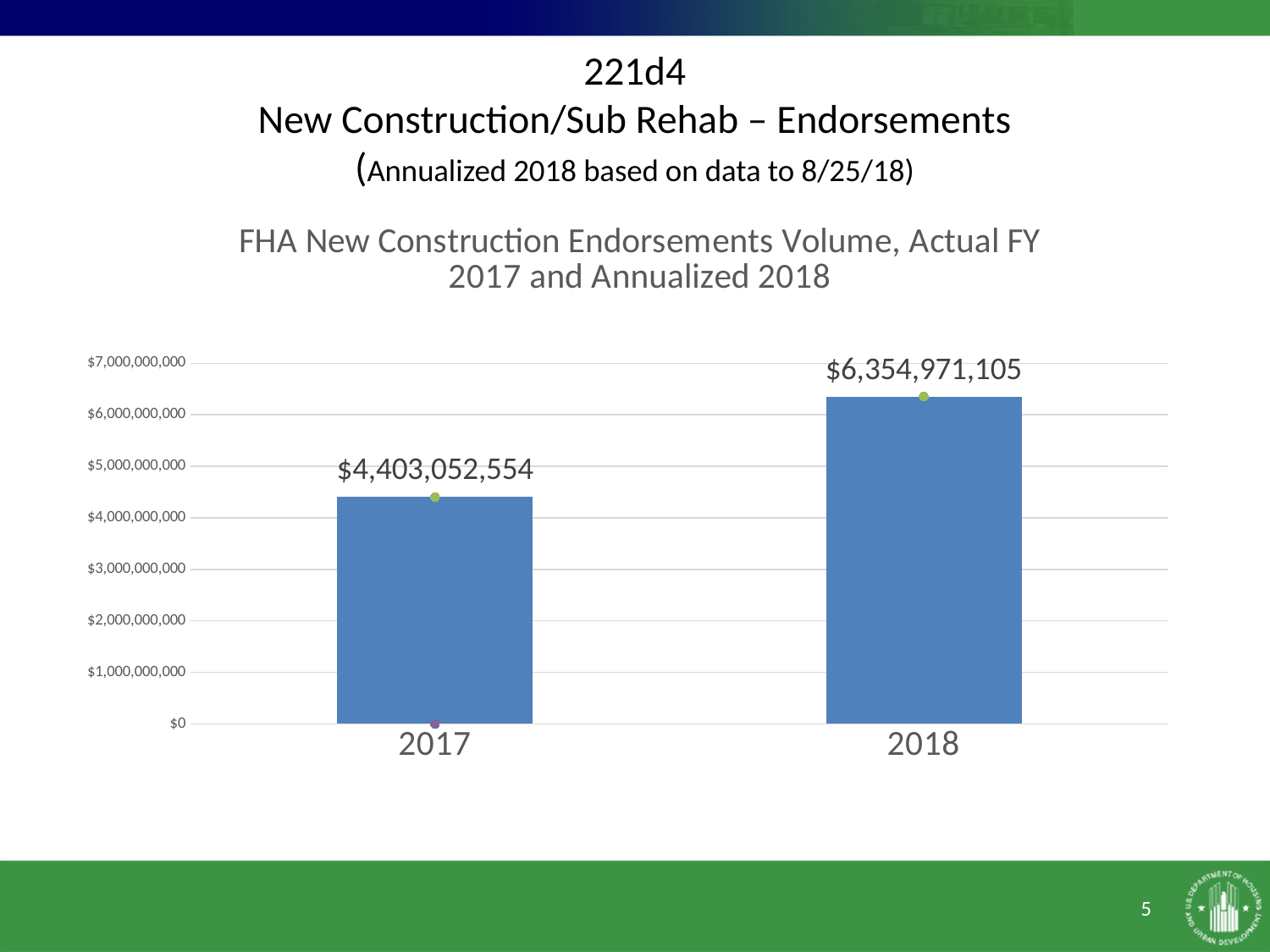
Is the endorsements volume larger in 2017 or in 2018? 2018 By how much does the 2018 endorsements volume exceed the 2017 volume? $1,951,918,551 How many years are shown on the chart? 2 What is the FHA New Construction Endorsements Volume for 2017? $4,403,052,554 What type of chart is shown on the slide? Bar chart What is the title of the chart? FHA New Construction Endorsements Volume, Actual FY 2017 and Annualized 2018 Is the 2018 endorsements volume greater or less than $6,000,000,000? greater Which year has the lower endorsements volume? 2017 Is the 2017 endorsements volume greater or less than $5,000,000,000? less Does the endorsements volume rise or fall from 2017 to 2018? Rise Which year has the higher endorsements volume? 2018 What is the FHA New Construction Endorsements Volume for annualized 2018? $6,354,971,105